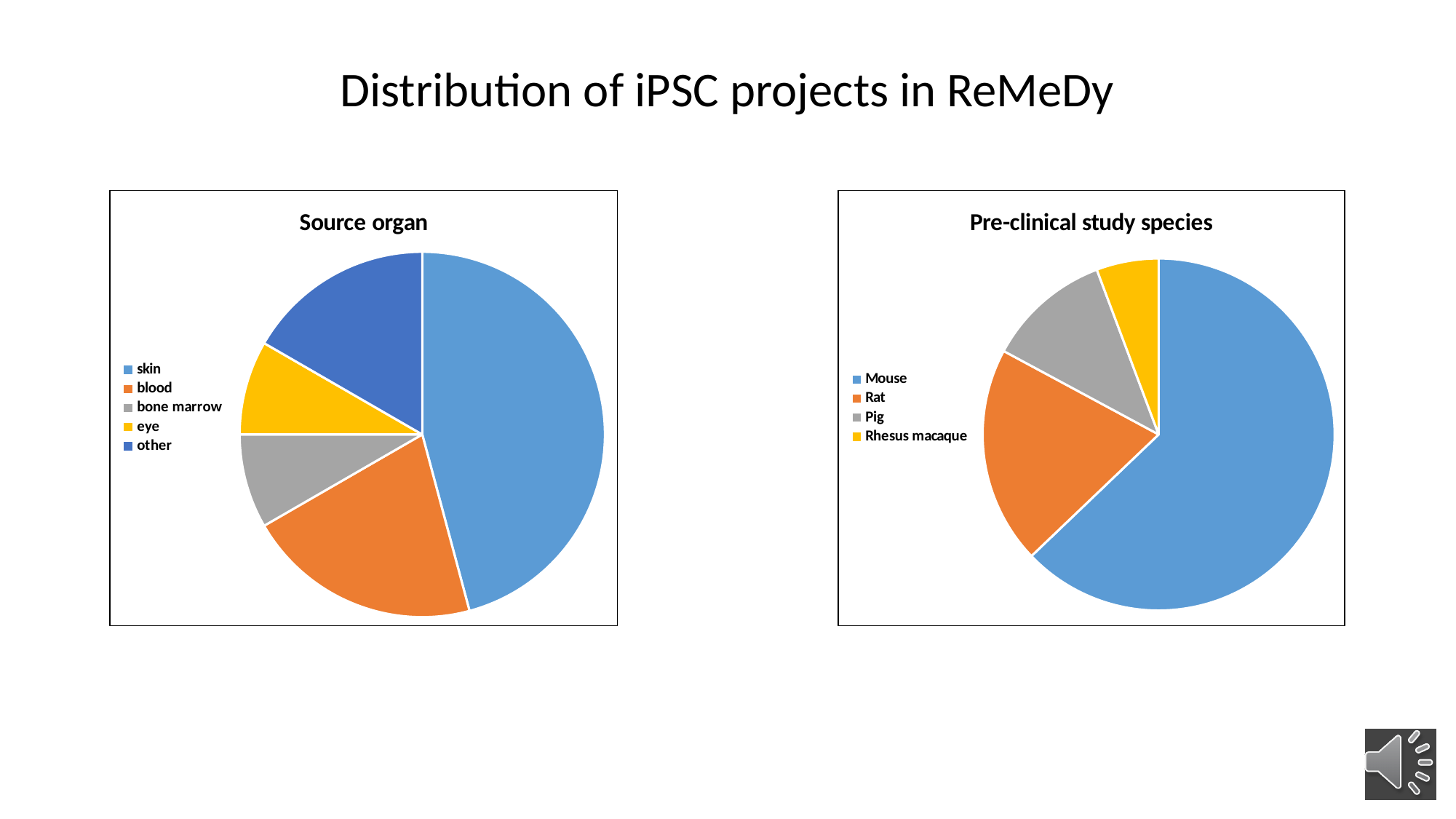
In the "Source organ" chart, which category has the largest slice? skin What is the title of the slide? Distribution of iPSC projects in ReMeDy In the "Source organ" chart, how many categories are shown? 5 What kind of chart is the "Source organ" chart? pie chart What kind of chart is the "Pre-clinical study species" chart? pie chart In the "Source organ" chart, which slice is larger, other or bone marrow? other In the "Pre-clinical study species" chart, which slice is larger, Rat or Pig? Rat In the "Source organ" chart, which slice is larger, blood or other? blood In the "Source organ" chart, which colour represents eye? yellow In the "Pre-clinical study species" chart, which species has the smallest slice? Rhesus macaque In the "Pre-clinical study species" chart, how many categories are shown? 4 In the "Pre-clinical study species" chart, which species has the largest slice? Mouse